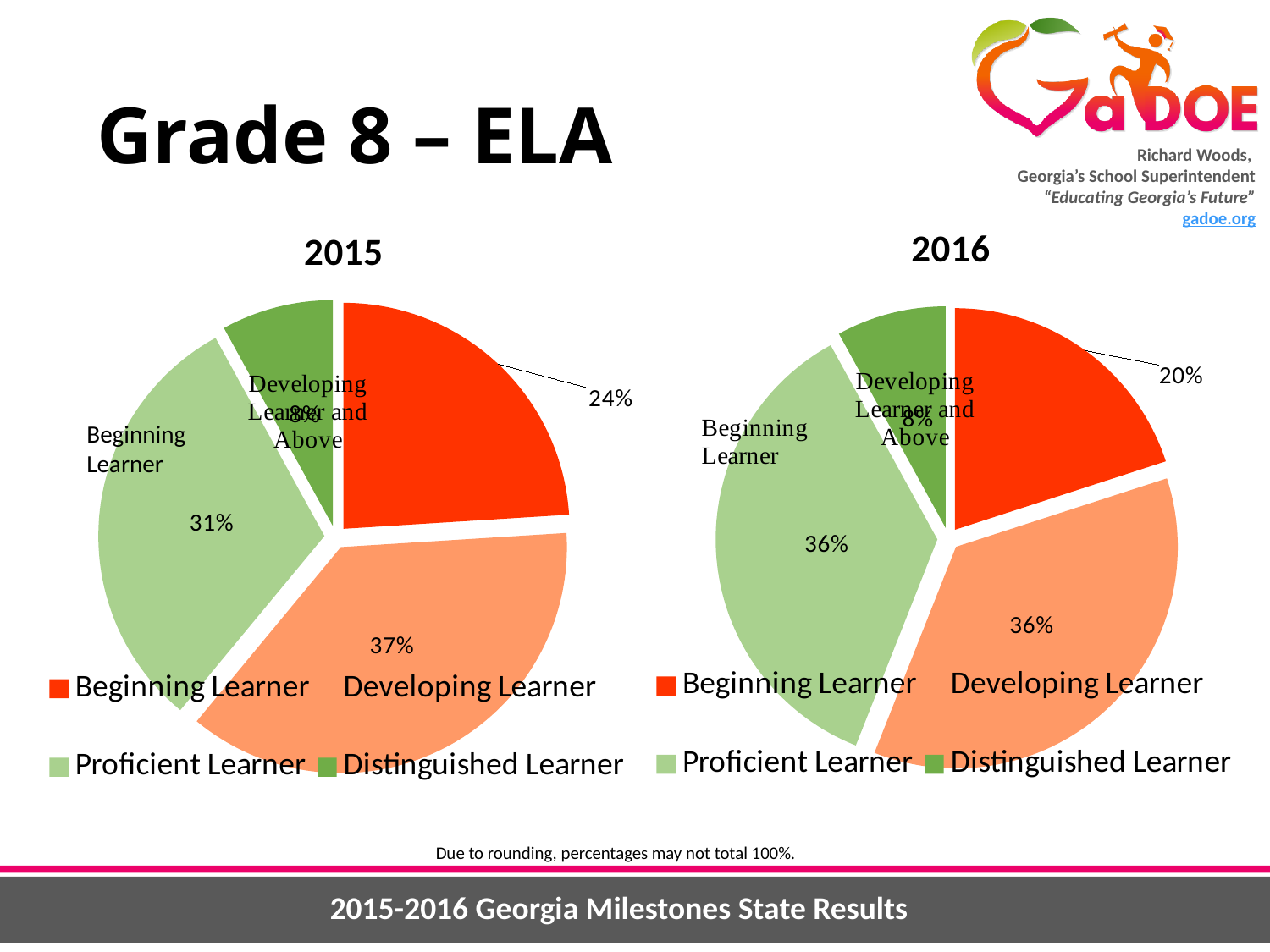
In the 2015 chart, which category has the smallest share? Distinguished Learner In the 2016 chart, what percentage is shown for Beginning Learner? 20% In the 2015 chart, what is the difference between the Developing Learner and Proficient Learner percentages? 6 percentage points How many categories does the legend of the 2016 chart list? 4 What type of chart is used for the 2015 chart? pie chart In the 2016 chart, which category has the smallest share? Distinguished Learner In the 2015 chart, what percentage is shown for Beginning Learner? 24% In the 2015 chart, which category has the largest share? Developing Learner By how many percentage points did the Beginning Learner share fall from the 2015 chart to the 2016 chart? 4 percentage points In the 2015 chart, which is larger: Beginning Learner or Proficient Learner? Proficient Learner In the 2015 chart, what percentage is shown for Developing Learner? 37% In the 2016 chart, what percentage is shown for Proficient Learner? 36%